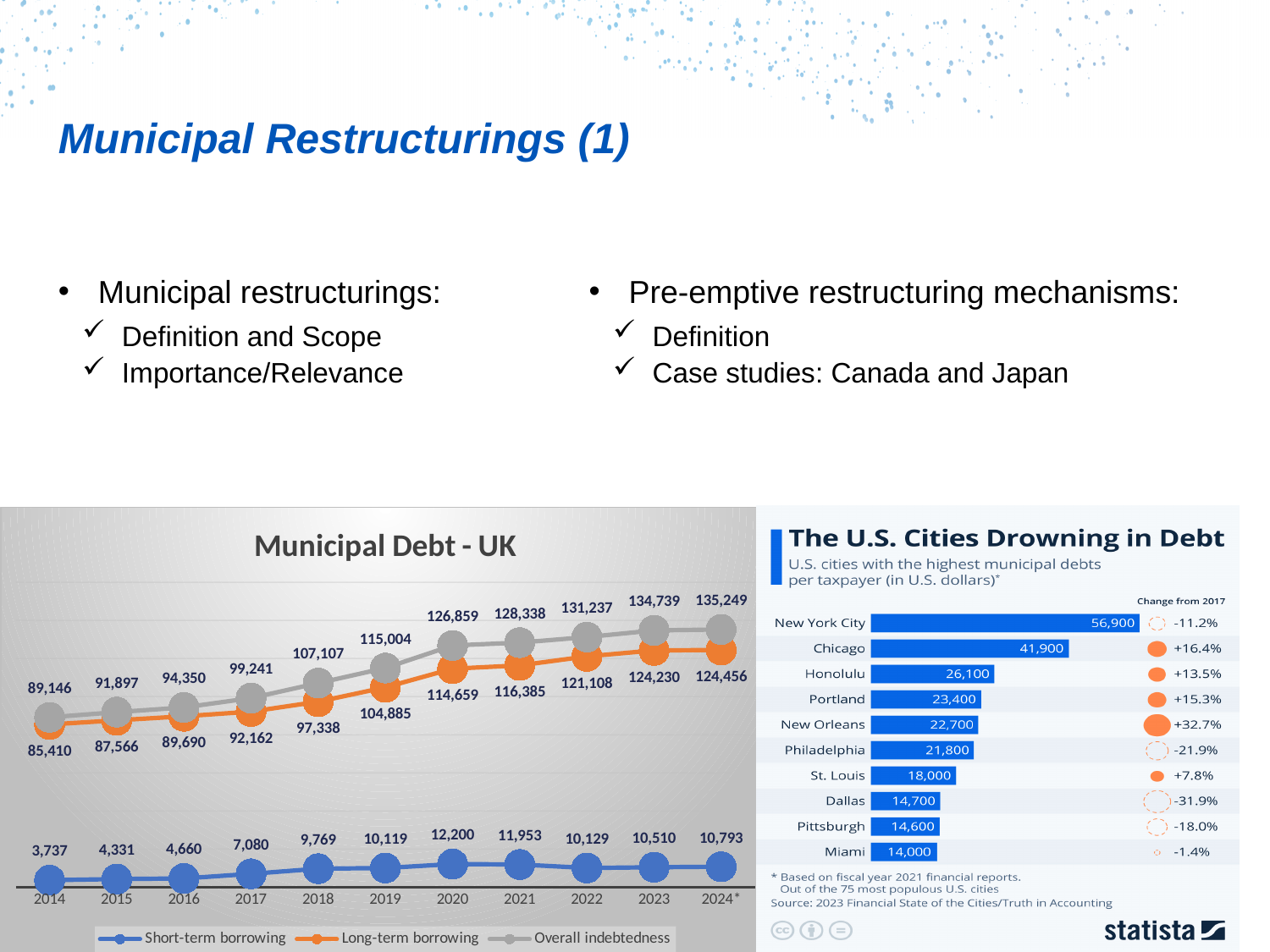
In the 'Municipal Debt - UK' chart, what is the difference between overall indebtedness in 2023 and in 2014? 45,593 In the 'Municipal Debt - UK' chart, does long-term borrowing generally rise or fall from 2014 to 2024*? rise In the 'Municipal Debt - UK' chart, in which year is short-term borrowing highest? 2020 In the 'Municipal Debt - UK' chart, what is the short-term borrowing value for 2020? 12,200 In 'The U.S. Cities Drowning in Debt' chart, which city has the lowest municipal debt per taxpayer? Miami In 'The U.S. Cities Drowning in Debt' chart, what is the municipal debt per taxpayer for Chicago? 41,900 In the 'Municipal Debt - UK' chart, what is the long-term borrowing value for 2019? 104,885 What kind of chart is 'The U.S. Cities Drowning in Debt'? bar chart In 'The U.S. Cities Drowning in Debt' chart, what is the change from 2017 shown for New Orleans? +32.7% In the 'Municipal Debt - UK' chart, what is the overall indebtedness value for 2024*? 135,249 In the 'Municipal Debt - UK' chart, how many series does the legend list? 3 In 'The U.S. Cities Drowning in Debt' chart, how many cities are shown? 10